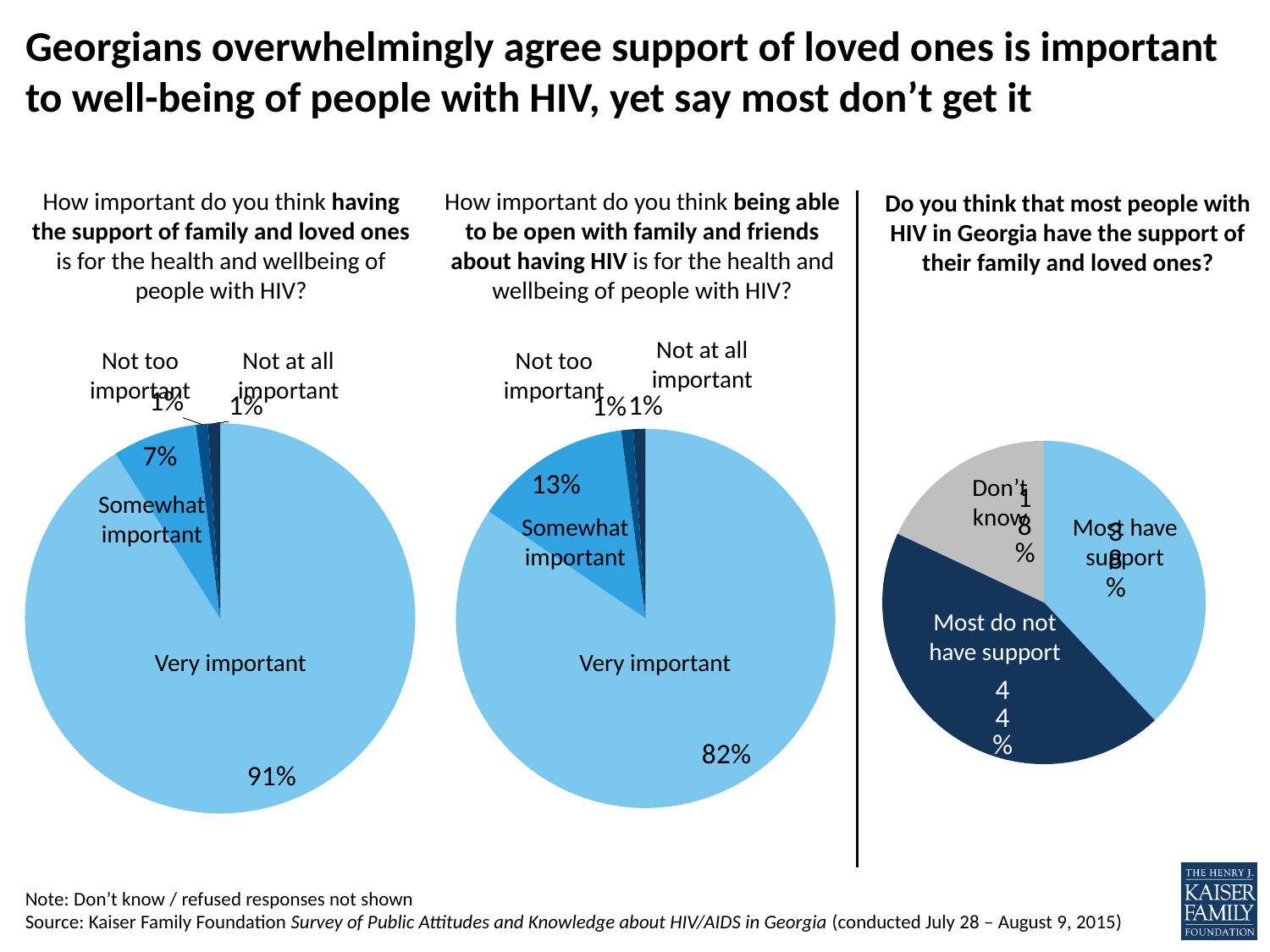
In the left pie chart (support of family and loved ones), what share said 'Somewhat important'? 7% In the right pie chart, what share said 'Most do not have support'? 44% In the left pie chart, which response has the largest share? Very important How many pie charts are shown on the slide? 3 In the middle pie chart (being able to be open with family and friends), what share said 'Somewhat important'? 13% What is the difference between the 'Very important' share in the left pie chart and the 'Very important' share in the middle pie chart? 9 percentage points In the left pie chart (support of family and loved ones), what share said 'Very important'? 91% In the middle pie chart, what share said 'Not too important'? 1% In the middle pie chart (being able to be open with family and friends), what share said 'Very important'? 82% Which is larger: the 'Somewhat important' share in the left pie chart or in the middle pie chart? Middle pie chart (13%) What type of chart is used for the three questions on the slide? Pie chart In the right pie chart (whether most people with HIV in Georgia have support), which response has the largest share? Most do not have support